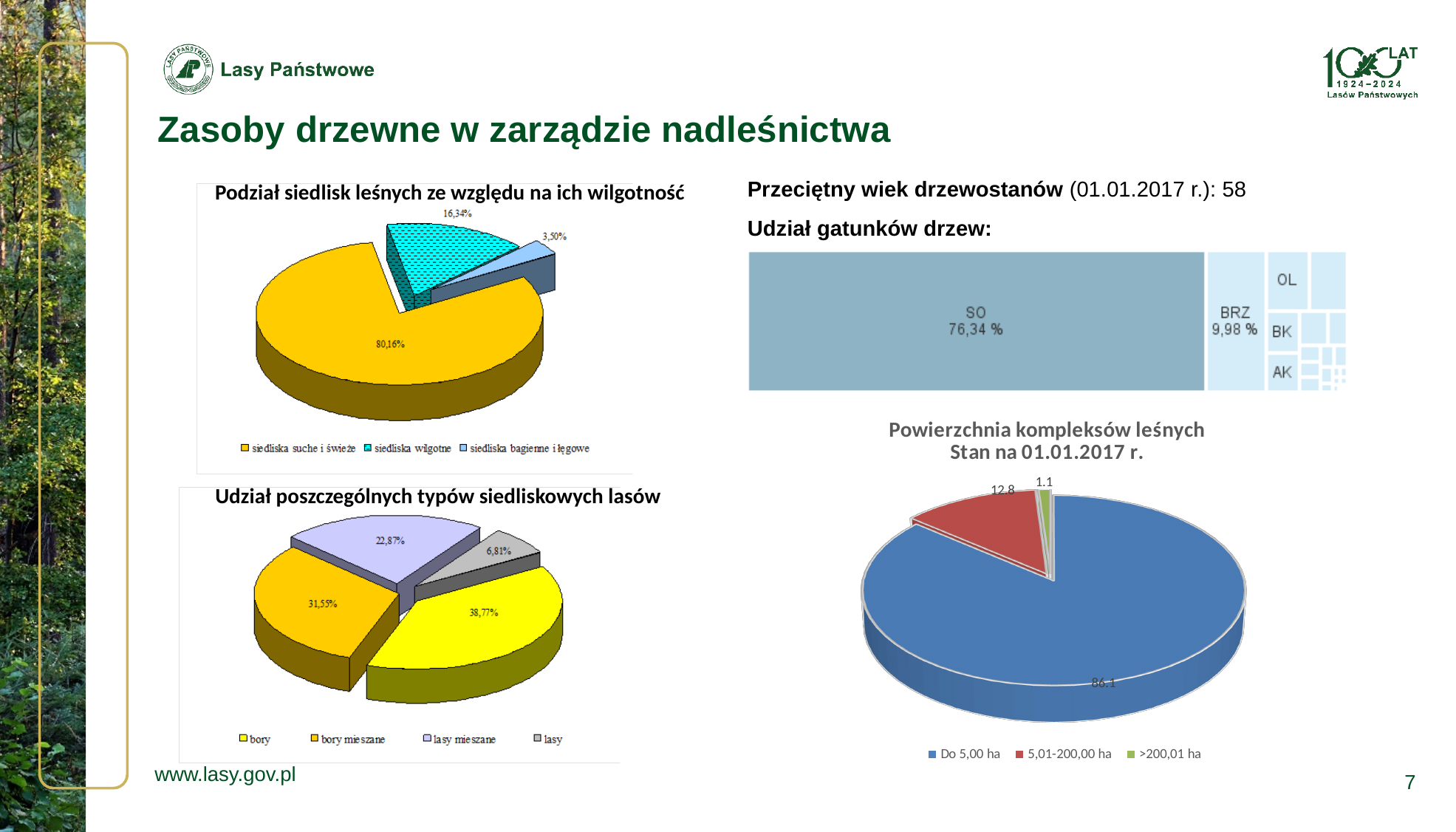
In the chart 'Udział poszczególnych typów siedliskowych lasów', what is the value for bory mieszane? 31,55% In the chart 'Udział poszczególnych typów siedliskowych lasów', what is the difference between bory and lasy? 31,96% In the chart 'Podział siedlisk leśnych ze względu na ich wilgotność', what kind of chart is shown? pie chart In the chart 'Podział siedlisk leśnych ze względu na ich wilgotność', what is the value for siedliska suche i świeże? 80,16% In the 'Udział gatunków drzew' chart, what is the share for SO? 76,34 % In the chart 'Podział siedlisk leśnych ze względu na ich wilgotność', what is the value for siedliska bagienne i łęgowe? 3,50% In the chart 'Udział poszczególnych typów siedliskowych lasów', which category has the largest share? bory In the chart 'Powierzchnia kompleksów leśnych Stan na 01.01.2017 r.', what is the value for Do 5,00 ha? 86.1 In the chart 'Podział siedlisk leśnych ze względu na ich wilgotność', which category has the smallest share? siedliska bagienne i łęgowe In the chart 'Powierzchnia kompleksów leśnych Stan na 01.01.2017 r.', what is the difference between Do 5,00 ha and 5,01-200,00 ha? 73.3 In the chart 'Powierzchnia kompleksów leśnych Stan na 01.01.2017 r.', which is larger: 5,01-200,00 ha or >200,01 ha? 5,01-200,00 ha In the chart 'Udział poszczególnych typów siedliskowych lasów', how many categories does the legend list? 4